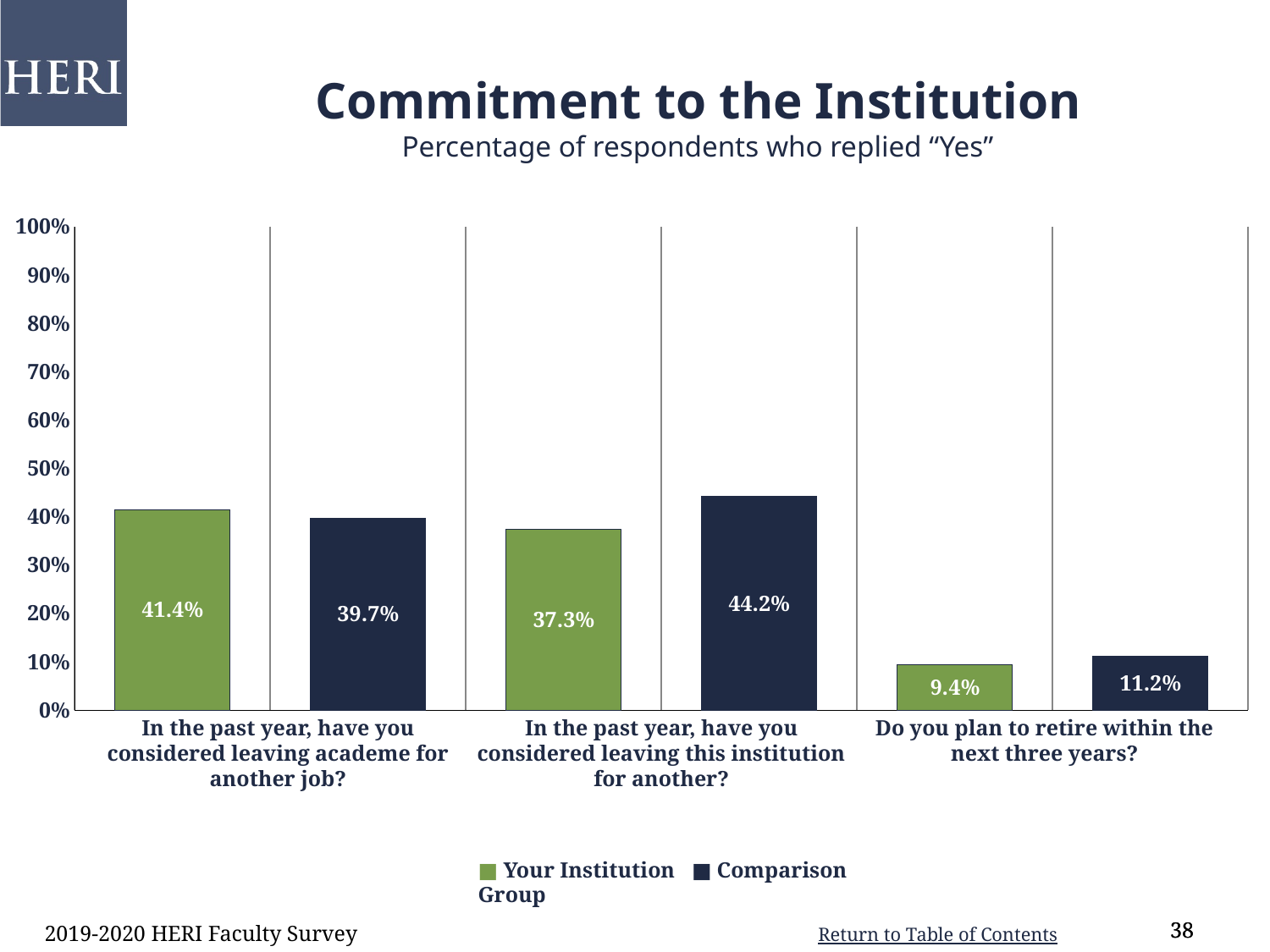
Is the Comparison Group value for "Do you plan to retire within the next three years?" greater or less than 20%? less What is the Comparison Group value for "Do you plan to retire within the next three years?" 11.2% How many questions (categories) are shown on the x axis? 3 For "In the past year, have you considered leaving academe for another job?", which is larger: Your Institution or Comparison Group? Your Institution How many series does the legend list? 2 Which question has the highest Comparison Group value? In the past year, have you considered leaving this institution for another? What is the Your Institution value for "Do you plan to retire within the next three years?" 9.4% What kind of chart is shown on the slide? bar chart What percentage of respondents at Your Institution replied "Yes" to "In the past year, have you considered leaving academe for another job?" 41.4% What is the Comparison Group value for "In the past year, have you considered leaving this institution for another?" 44.2% Which question has the lowest Your Institution value? Do you plan to retire within the next three years? What is the difference between the Comparison Group and Your Institution values for "In the past year, have you considered leaving this institution for another?" 6.9%